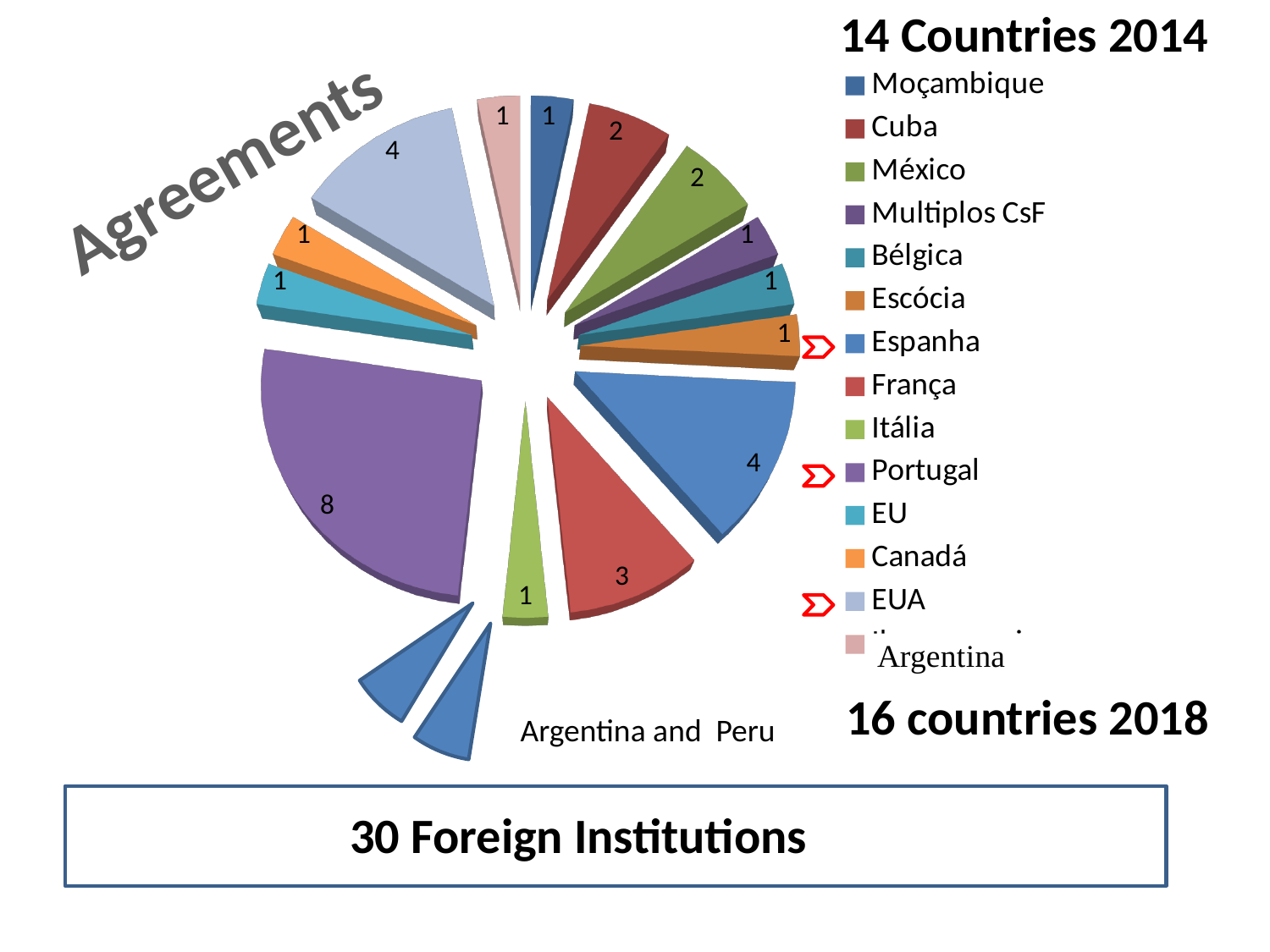
What is the difference between the values for Portugal and Espanha? 4 Which country has the largest slice in the pie chart? Portugal What is the value shown for França? 3 What colour is the Portugal slice in the pie chart? purple Which is larger, the value for França or the value for Cuba? França How many slices does the pie chart have? 14 What is the difference between the values for França and Itália? 2 What is the value shown for EUA? 4 What is the value shown for Cuba? 2 What is the value shown for Espanha? 4 What is the value shown for Portugal? 8 What kind of chart is shown on the slide? pie chart